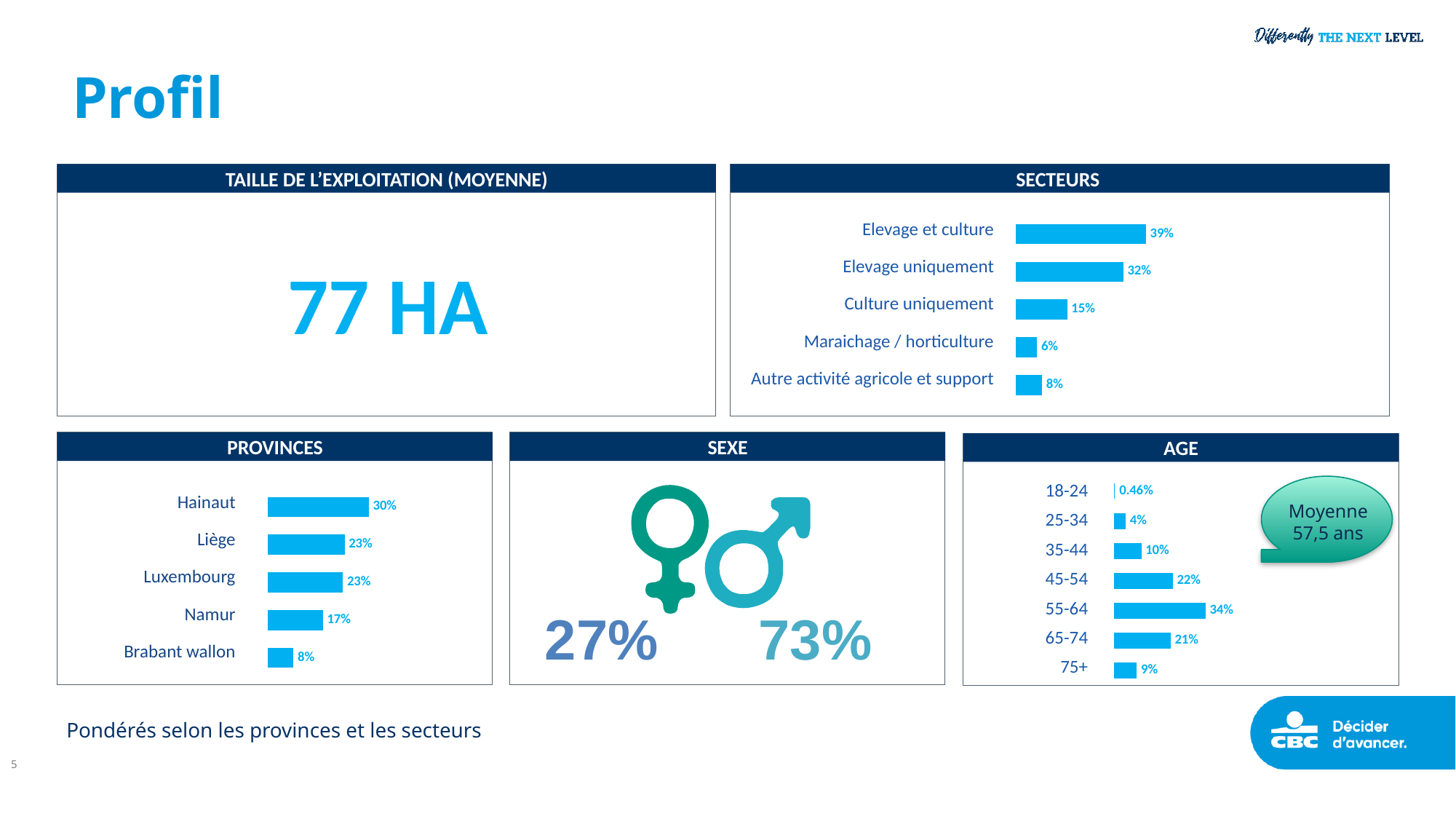
In the AGE chart, what is the difference between the 45-54 and 65-74 groups? 1% In the AGE chart, what is the value for the 55-64 group? 34% In the SECTEURS chart, what is the difference between Elevage et culture and Elevage uniquement? 7% In the PROVINCES chart, what is the value for Namur? 17% In the AGE chart, which age group has the lowest value? 18-24 In the PROVINCES chart, which province has the highest value? Hainaut In the SECTEURS chart, what is the value for Elevage et culture? 39% What kind of chart is the PROVINCES chart? Bar chart In the AGE chart, how many age groups are shown? 7 In the SECTEURS chart, which category has the lowest value? Maraichage / horticulture In the PROVINCES chart, which is larger, Hainaut or Brabant wallon? Hainaut In the SECTEURS chart, how many categories are shown? 5